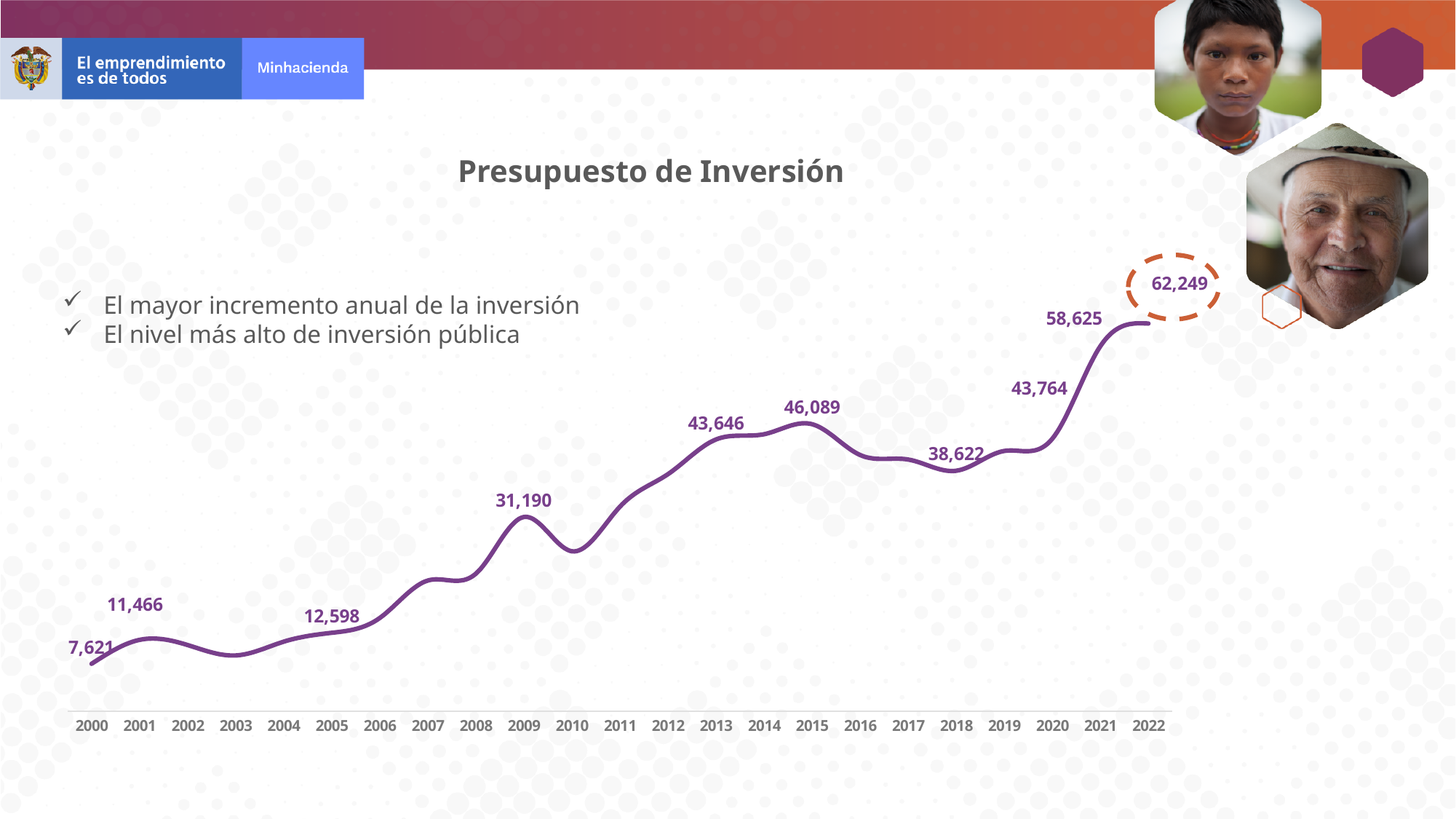
What is the value labelled for 2018? 38,622 How many years are shown on the x axis? 23 What is the title of the chart? Presupuesto de Inversión What is the value labelled for 2009? 31,190 Which is larger, the value for 2015 or the value for 2018? 2015 What type of chart is shown on the slide? line chart Which year has the highest value on the chart? 2022 What is the value labelled for 2000? 7,621 What is the value labelled for 2022? 62,249 Does the value rise or fall from 2018 to 2022? rise Which year has the lowest value on the chart? 2000 What is the difference between the values for 2022 and 2021? 3,624